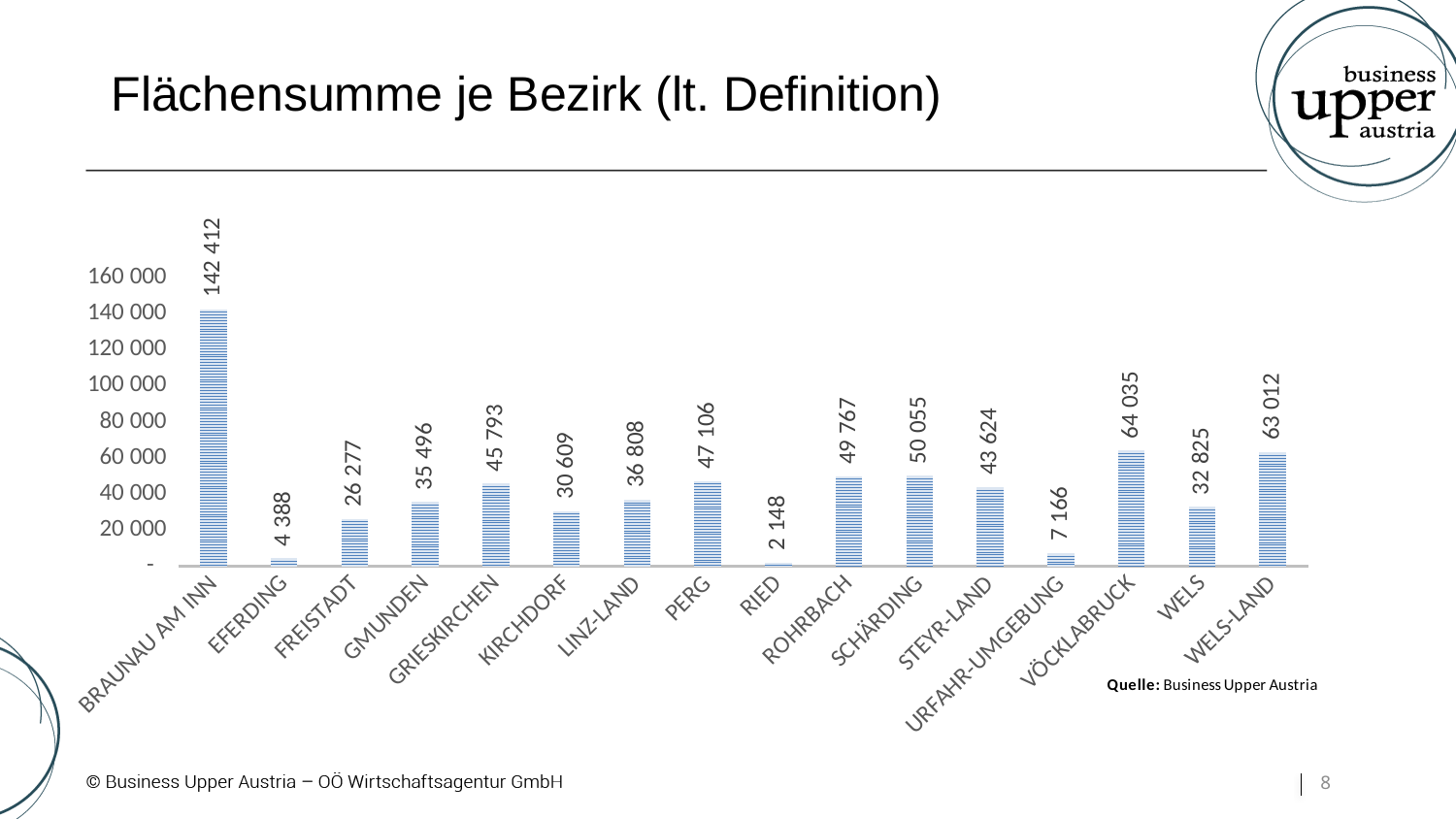
What kind of chart is shown on the slide? bar chart Which is larger, the value for Perg or the value for Grieskirchen? Perg What is the difference between the values for Vöcklabruck and Wels-Land? 1 023 How many districts are shown in the chart? 16 Which district has the lowest value? Ried What is the value for Urfahr-Umgebung? 7 166 What is the difference between the values for Schärding and Rohrbach? 288 What is the value for Vöcklabruck? 64 035 What is the title of the chart? Flächensumme je Bezirk (lt. Definition) Which district has the highest value? Braunau am Inn What is the value for Braunau am Inn? 142 412 Is the value for Steyr-Land greater or less than 40 000? greater